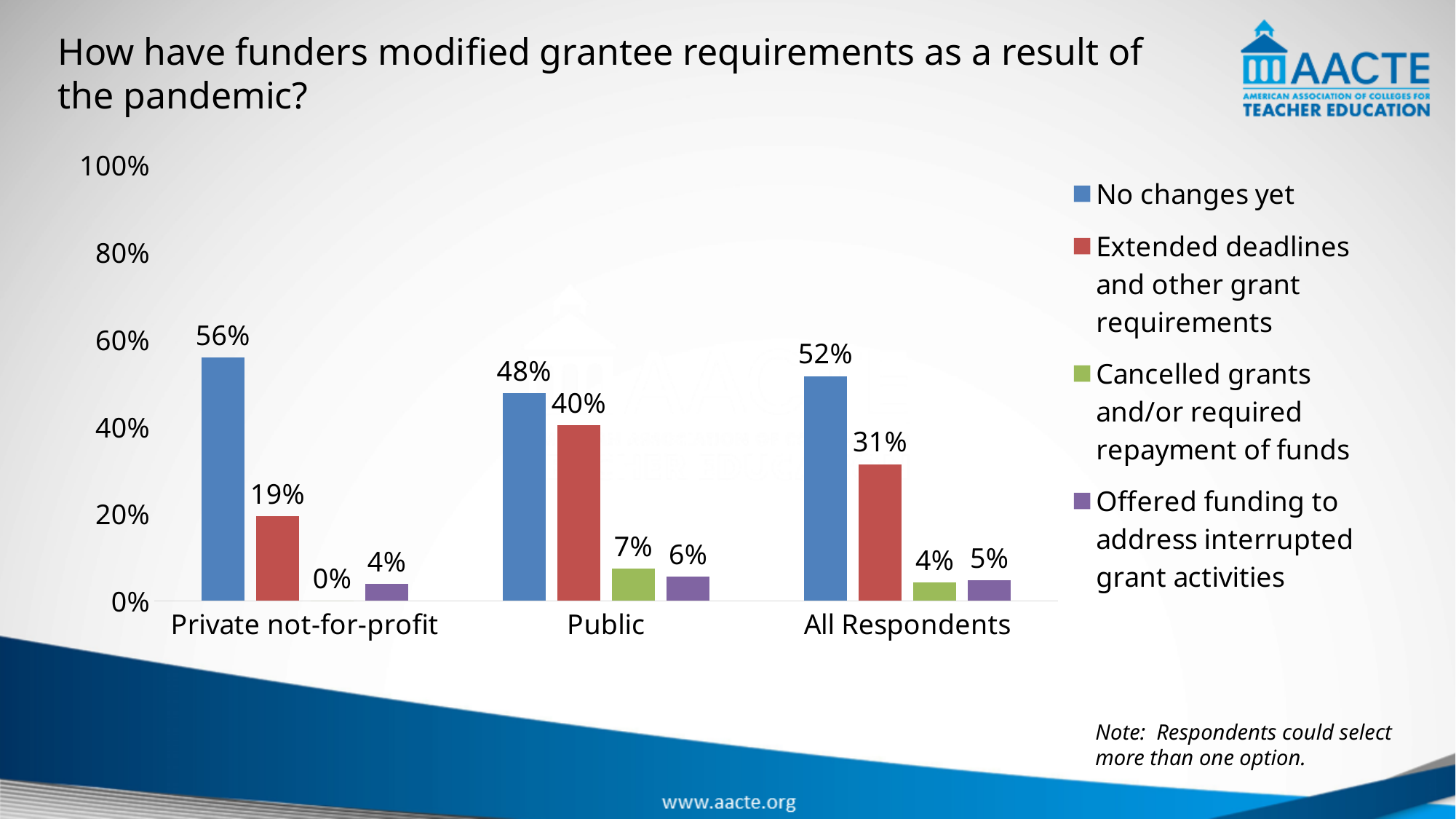
What is the value for "Cancelled grants and/or required repayment of funds" for Private not-for-profit? 0% What is the difference between the "No changes yet" values for Private not-for-profit and Public? 8% What is the value for "Offered funding to address interrupted grant activities" among All Respondents? 5% How many series does the legend list? 4 What is the value for "Extended deadlines and other grant requirements" among Public respondents? 40% Which category has the highest value for "No changes yet"? Private not-for-profit Which is larger for Public respondents: "Cancelled grants and/or required repayment of funds" or "Offered funding to address interrupted grant activities"? Cancelled grants and/or required repayment of funds Which category has the lowest value for "Extended deadlines and other grant requirements"? Private not-for-profit Is the "No changes yet" value for All Respondents greater or less than 40%? greater What kind of chart is shown on the slide? Bar chart What percentage of Private not-for-profit respondents reported "No changes yet"? 56% How many categories are shown on the x axis? 3